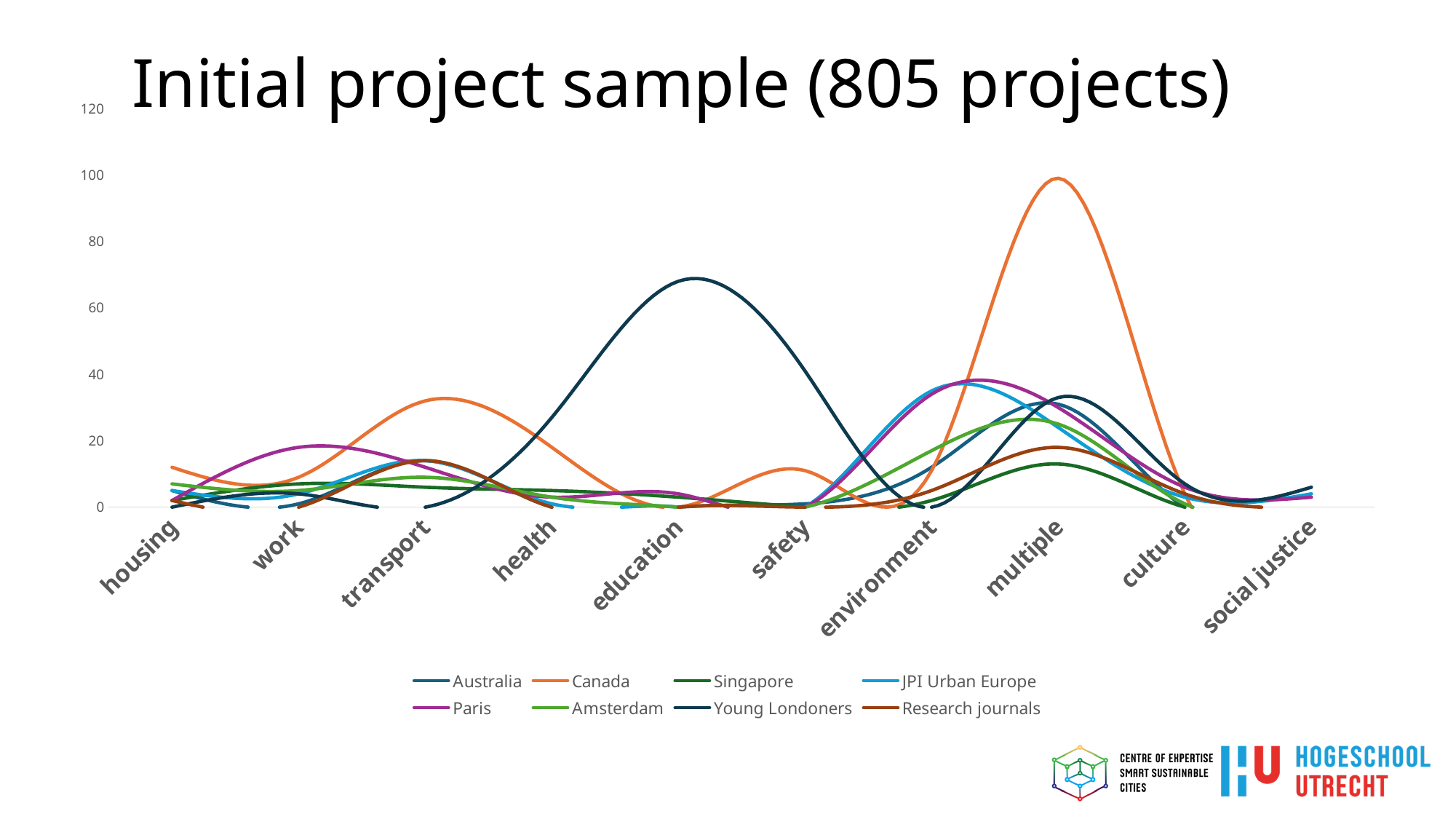
For the Young Londoners series, which category has the highest value? education How many series does the legend list? 8 For the Canada series, which category has the highest value? multiple Is the value for Canada at transport greater or less than 20? greater Does the Canada series rise or fall from multiple to culture? fall Is the value for Young Londoners at education greater or less than 60? greater What kind of chart is shown on the slide? line chart Which is larger: the Canada value at multiple or the Young Londoners value at education? Canada at multiple Which series reaches the highest value anywhere on the chart? Canada Is the value for Canada at multiple greater or less than 80? greater What is the title of the slide containing the chart? Initial project sample (805 projects) How many categories are shown along the x axis? 10